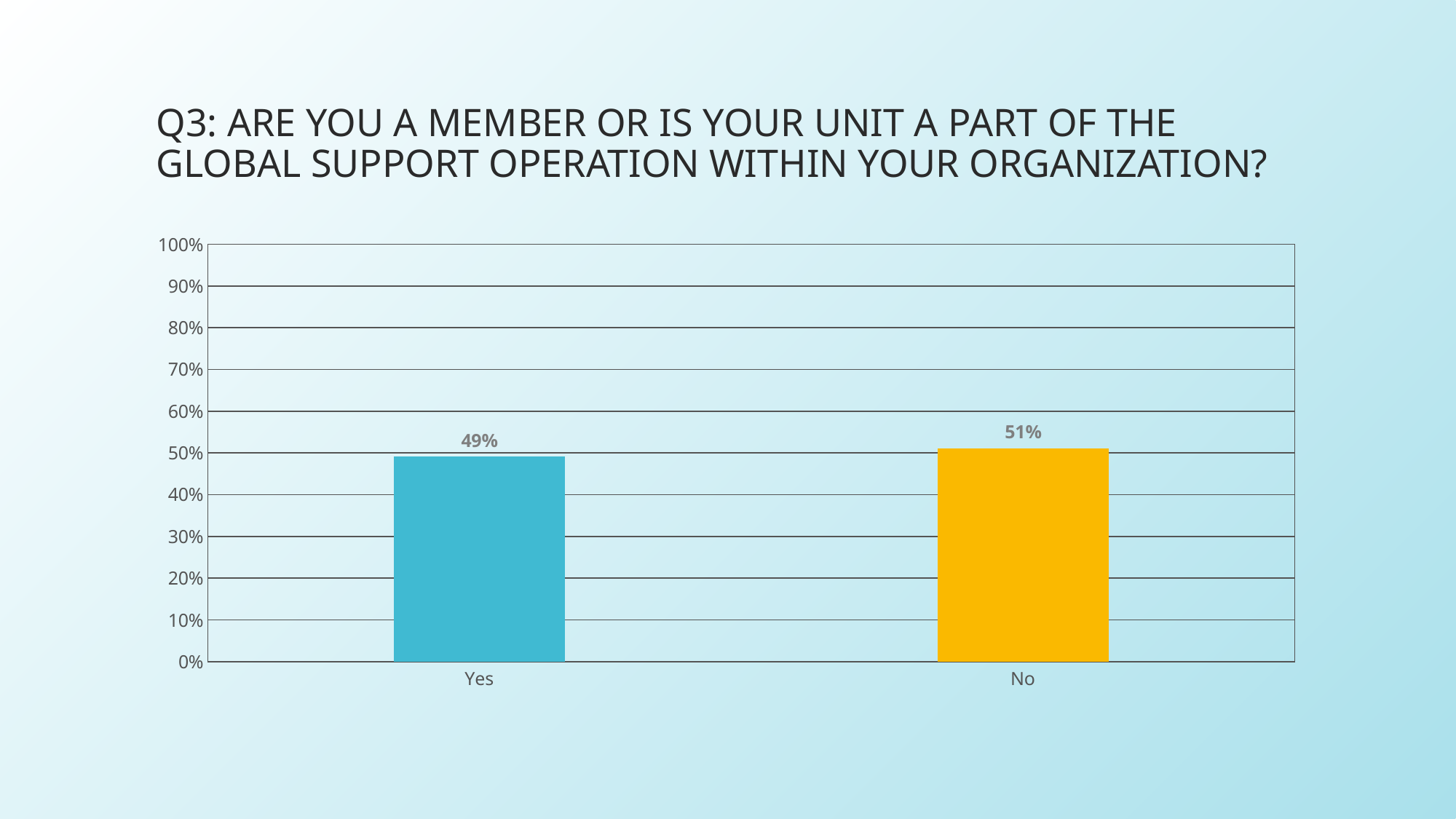
Which is larger, the value for Yes or the value for No? No What colour is the bar for No? yellow What is the difference between the values for No and Yes? 2% What kind of chart is shown on the slide? bar chart What is the value for No? 51% Is the value for No greater or less than 50%? greater Is the value for Yes greater or less than 50%? less What is the value for Yes? 49% Which category has the highest value? No How many categories are shown on the chart? 2 What is the maximum value shown on the vertical axis? 100% Which category has the lowest value? Yes